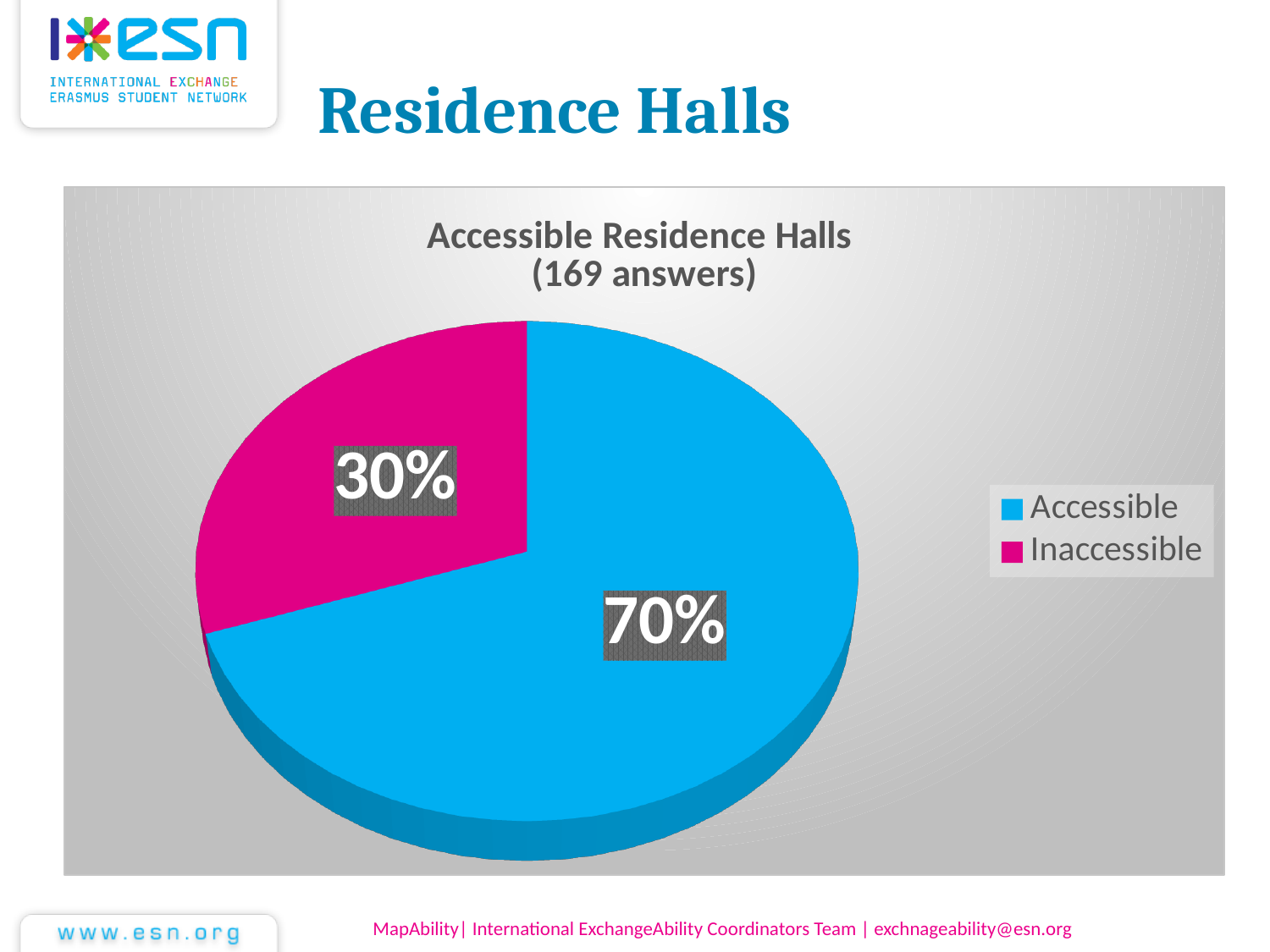
What kind of chart is shown on the slide? pie chart How many answers does the chart title say the data is based on? 169 What is the difference in percentage points between the Accessible and Inaccessible slices? 40 percentage points What share of the pie is labelled Accessible? 70% Which slice is the smallest? Inaccessible What is the title of the chart? Accessible Residence Halls (169 answers) How many entries does the legend list? 2 How many slices does the pie chart have? 2 What share of the pie is labelled Inaccessible? 30% Which slice is the largest? Accessible Which is larger, the Accessible slice or the Inaccessible slice? Accessible